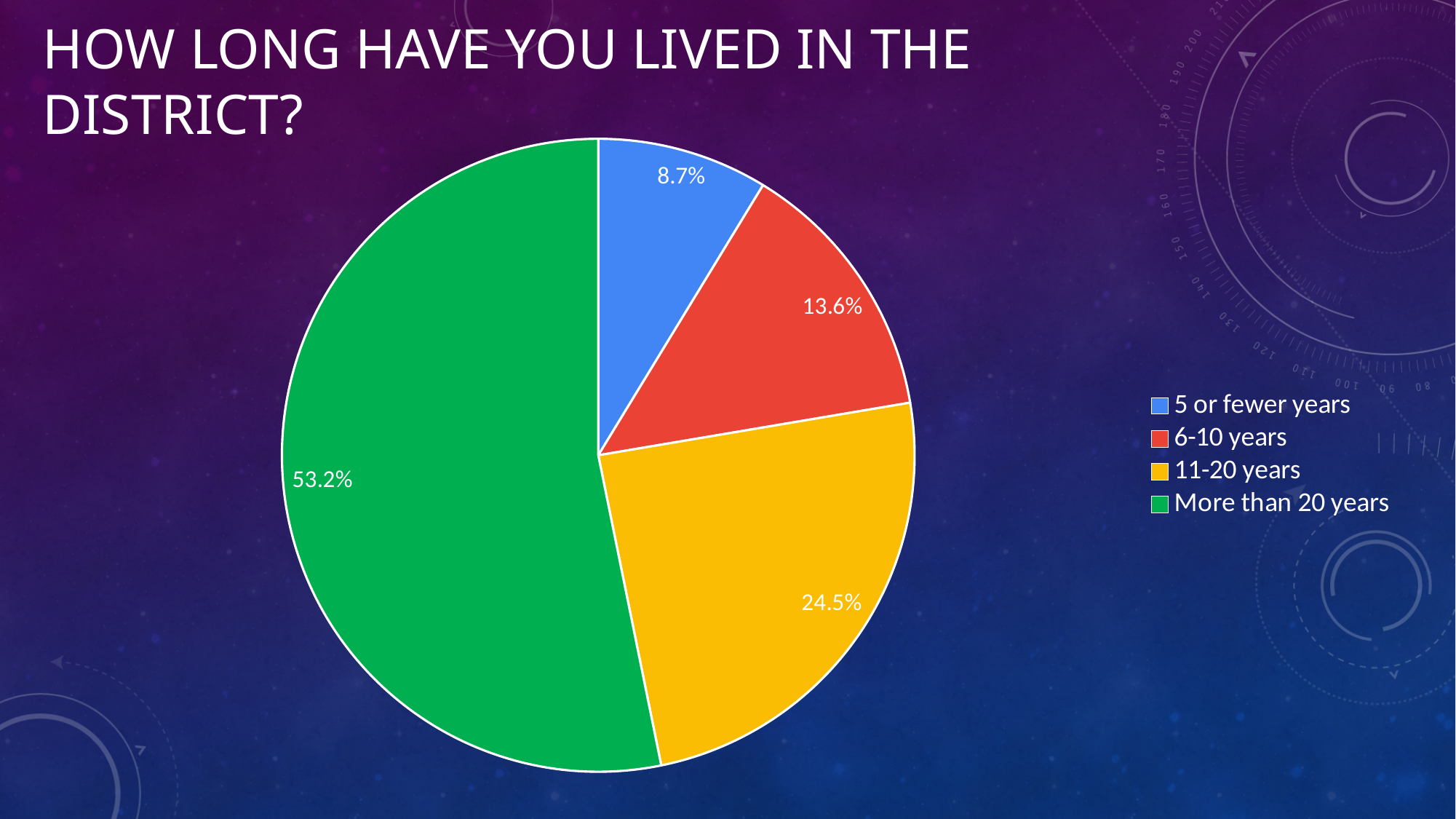
What percentage of respondents have lived in the district for 6-10 years? 13.6% What percentage of respondents have lived in the district for more than 20 years? 53.2% What kind of chart is shown on the slide? pie chart What is the difference in percentage points between the 'More than 20 years' slice and the '11-20 years' slice? 28.7 What percentage of respondents have lived in the district for 11-20 years? 24.5% Which category has the smallest share of the pie? 5 or fewer years What is the title of the slide? How long have you lived in the district? What colour is the slice for 11-20 years? yellow Which category has the largest share of the pie? More than 20 years Which is larger: the share for 6-10 years or the share for 11-20 years? 11-20 years What percentage of respondents have lived in the district for 5 or fewer years? 8.7% How many categories does the pie chart show? 4